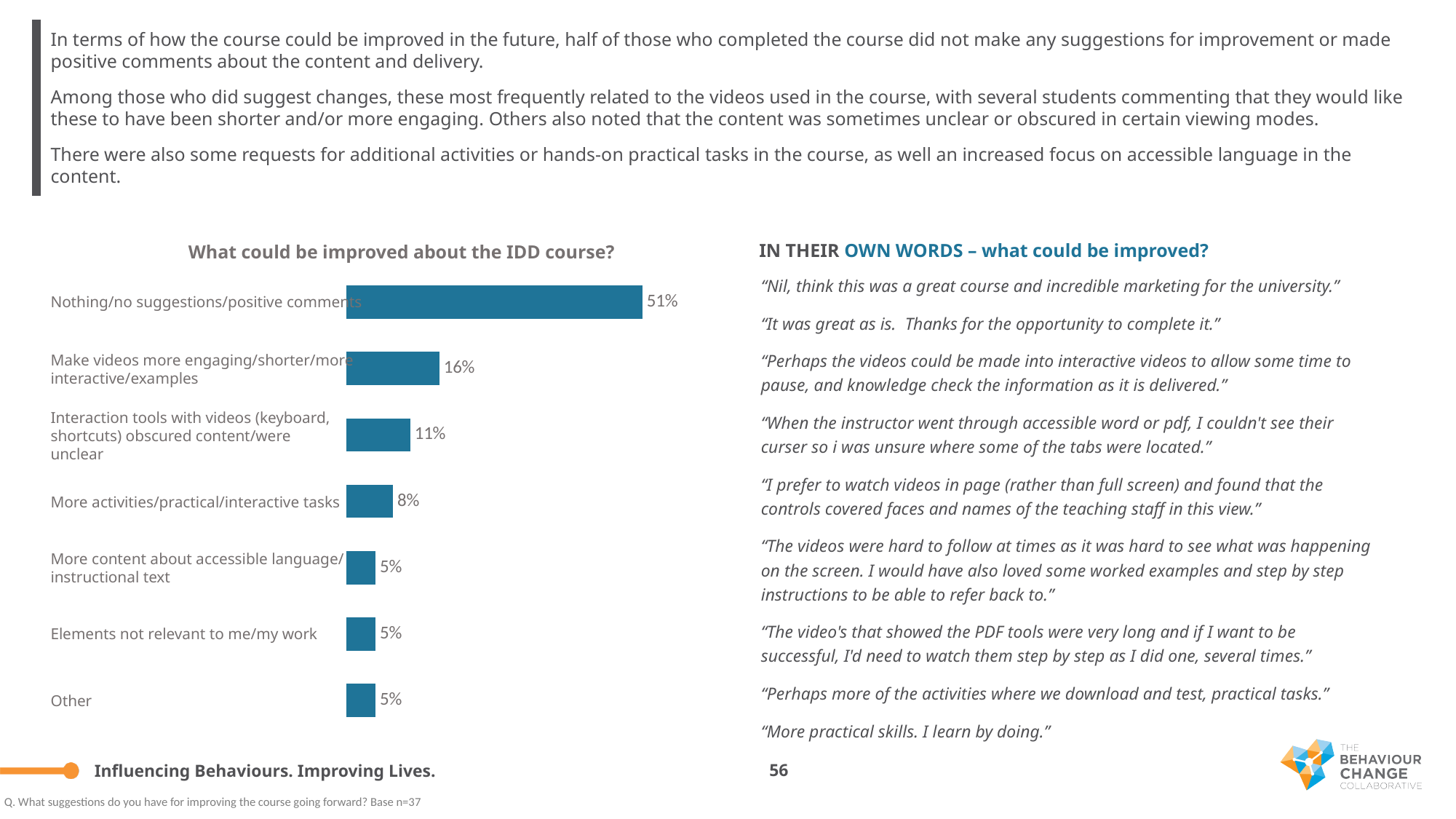
What is the title of the chart? What could be improved about the IDD course? What type of chart is used to show what could be improved about the IDD course? Bar chart What is the value for 'Make videos more engaging/shorter/more interactive/examples'? 16% Which is larger: the value for 'More activities/practical/interactive tasks' or 'Elements not relevant to me/my work'? More activities/practical/interactive tasks What percentage said interaction tools with videos (keyboard, shortcuts) obscured content/were unclear? 11% What percentage of respondents selected 'Other'? 5% What is the value for 'More activities/practical/interactive tasks'? 8% How many categories are shown in the chart? 7 What is the difference between the values for 'Interaction tools with videos (keyboard, shortcuts) obscured content/were unclear' and 'More activities/practical/interactive tasks'? 3 percentage points Which category has the highest value in the chart? Nothing/no suggestions/positive comments What percentage of respondents gave nothing/no suggestions/positive comments? 51% What is the difference between the value for 'Nothing/no suggestions/positive comments' and 'Make videos more engaging/shorter/more interactive/examples'? 35 percentage points